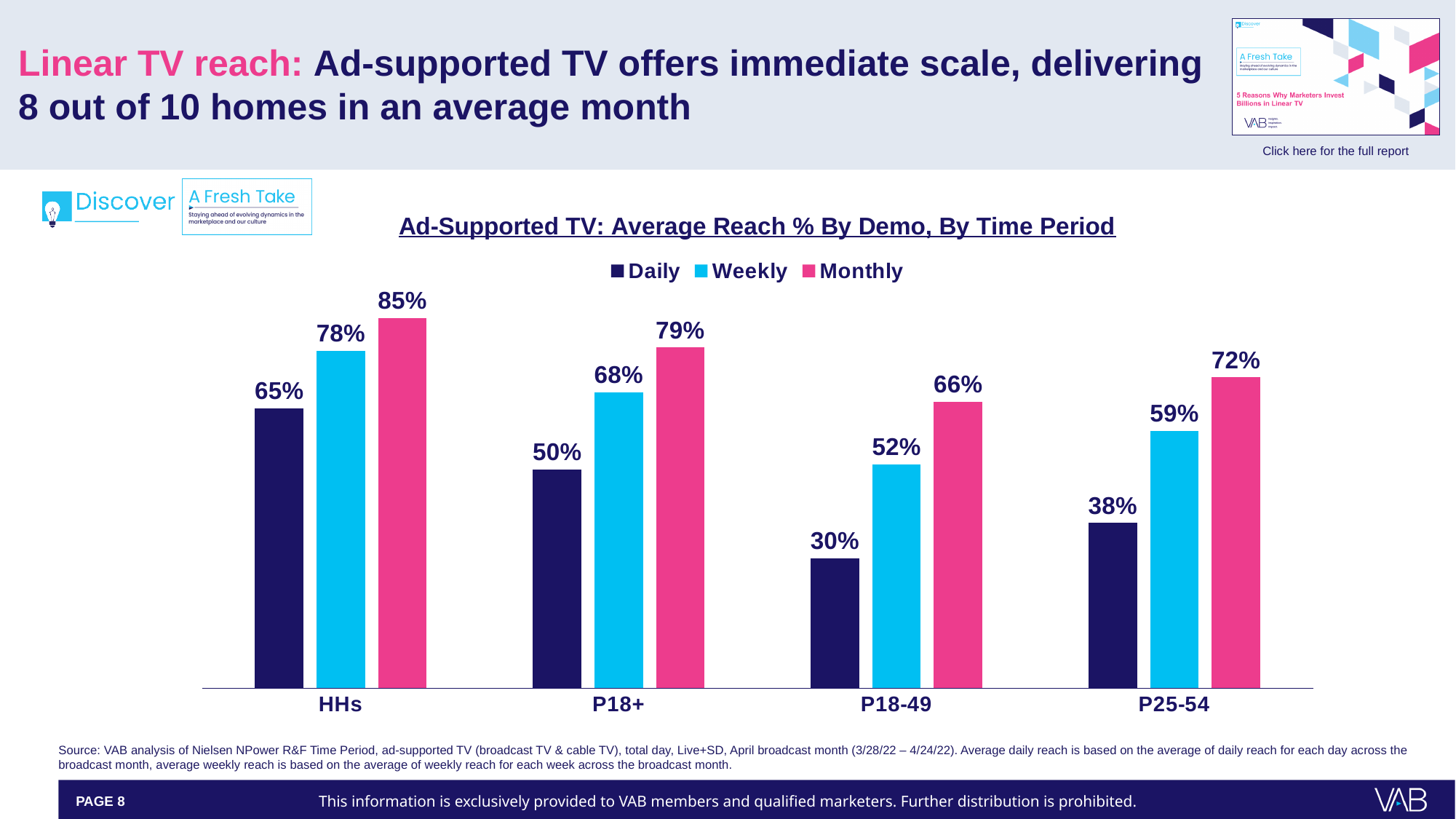
Which demo has the lowest Daily reach? P18-49 What kind of chart is shown on the slide? Bar chart What is the Daily reach for P18-49? 30% Which series is shown in pink in the legend? Monthly How many demo categories are shown on the x axis? 4 Which demo has the highest Monthly reach? HHs Which is larger: the Weekly reach for P18+ or the Weekly reach for P25-54? Weekly reach for P18+ What is the difference between the Monthly and Daily reach for P18+? 29% What is the Weekly reach for P25-54? 59% How many series does the legend list? 3 What is the Monthly reach for HHs? 85% What is the title of the chart? Ad-Supported TV: Average Reach % By Demo, By Time Period